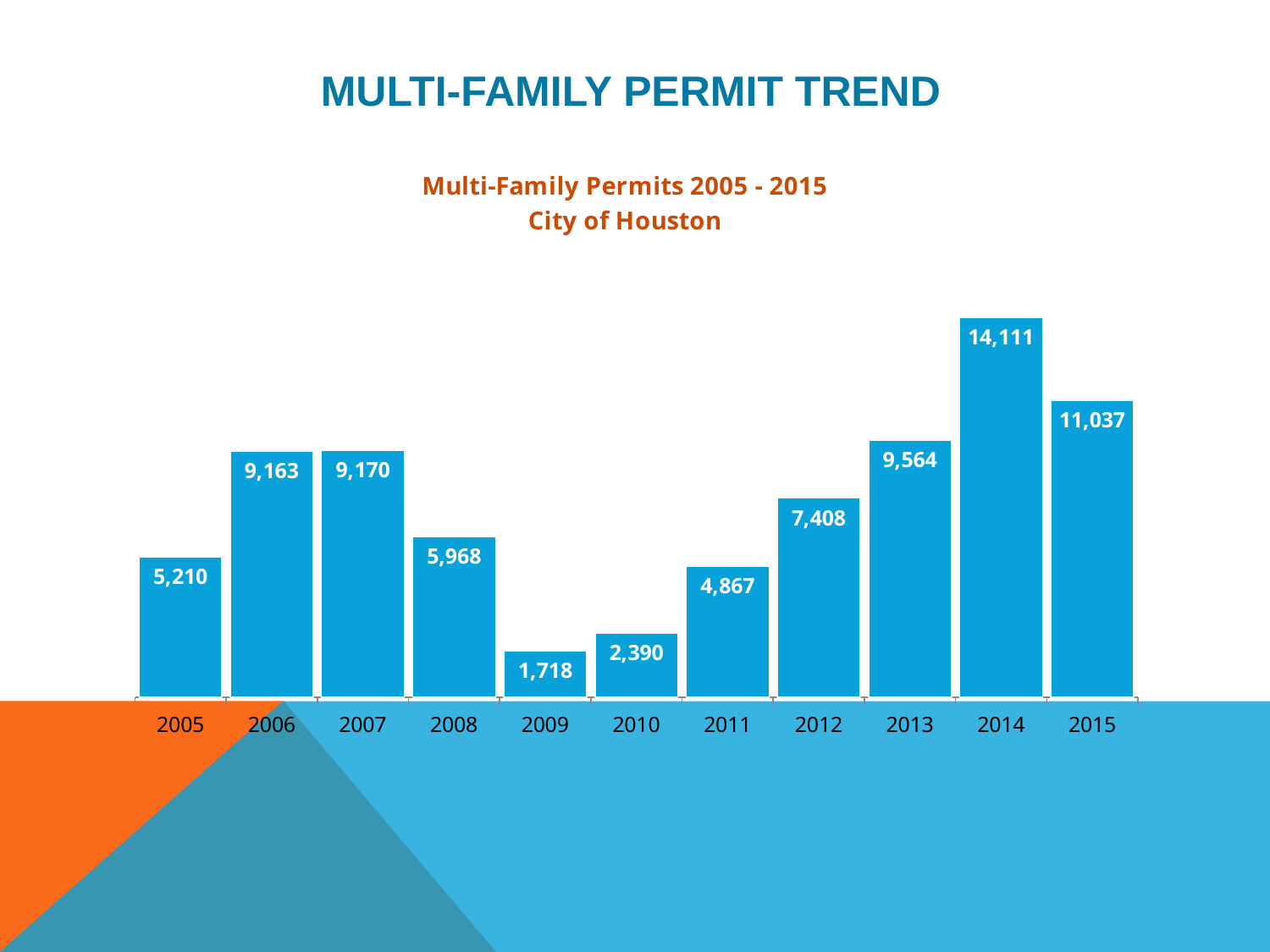
What is the number of multi-family permits in 2014? 14,111 How many years are shown on the chart? 11 What type of chart is shown on the slide? Bar chart Which year had more multi-family permits, 2013 or 2015? 2015 What is the number of multi-family permits in 2012? 7,408 What is the difference in permits between 2014 and 2015? 3,074 Which year has the highest number of multi-family permits? 2014 What is the number of multi-family permits in 2009? 1,718 Which year had more multi-family permits, 2005 or 2011? 2005 Which year has the lowest number of multi-family permits? 2009 Do the permit values rise or fall from 2009 to 2014? Rise What is the difference in permits between 2008 and 2009? 4,250